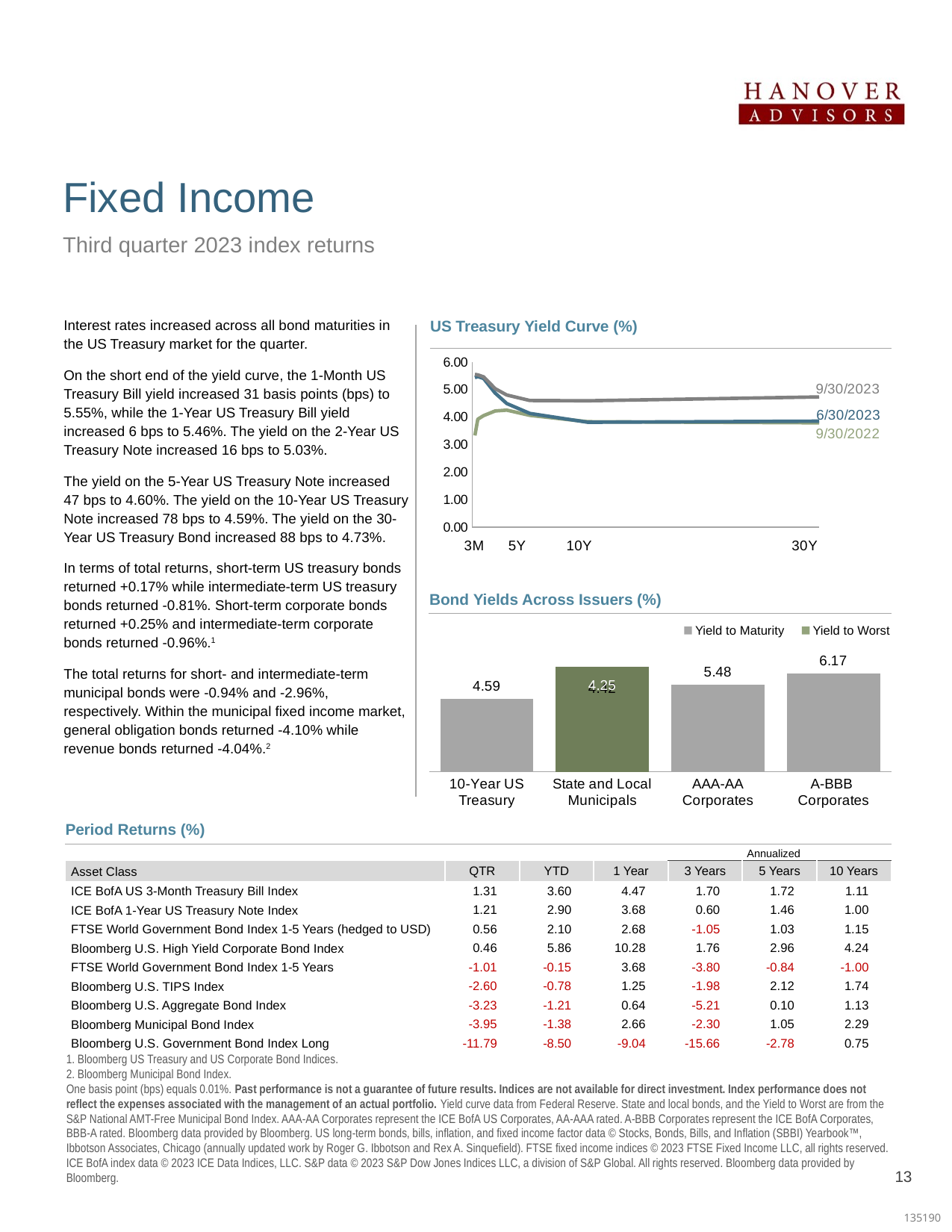
In the Bond Yields Across Issuers (%) chart, which is larger: the yield for AAA-AA Corporates or for the 10-Year US Treasury? AAA-AA Corporates What kind of chart is the US Treasury Yield Curve (%) chart? Line chart How many series does the legend of the Bond Yields Across Issuers (%) chart list? 2 How many categories are shown on the x axis of the Bond Yields Across Issuers (%) chart? 4 In the Bond Yields Across Issuers (%) chart, what is the difference between the A-BBB Corporates yield and the AAA-AA Corporates yield? 0.69 How many dated series are plotted in the US Treasury Yield Curve (%) chart? 3 In the Bond Yields Across Issuers (%) chart, what is the yield to maturity for A-BBB Corporates? 6.17 In the US Treasury Yield Curve (%) chart, is the 9/30/2023 value at 30Y greater or less than 4.00? greater In the US Treasury Yield Curve (%) chart, is the 9/30/2022 value at 3M greater or less than 4.00? less In the Bond Yields Across Issuers (%) chart, which category has the highest yield? A-BBB Corporates In the Bond Yields Across Issuers (%) chart, what is the yield to maturity for the 10-Year US Treasury? 4.59 In the Bond Yields Across Issuers (%) chart, what is the yield to maturity for AAA-AA Corporates? 5.48